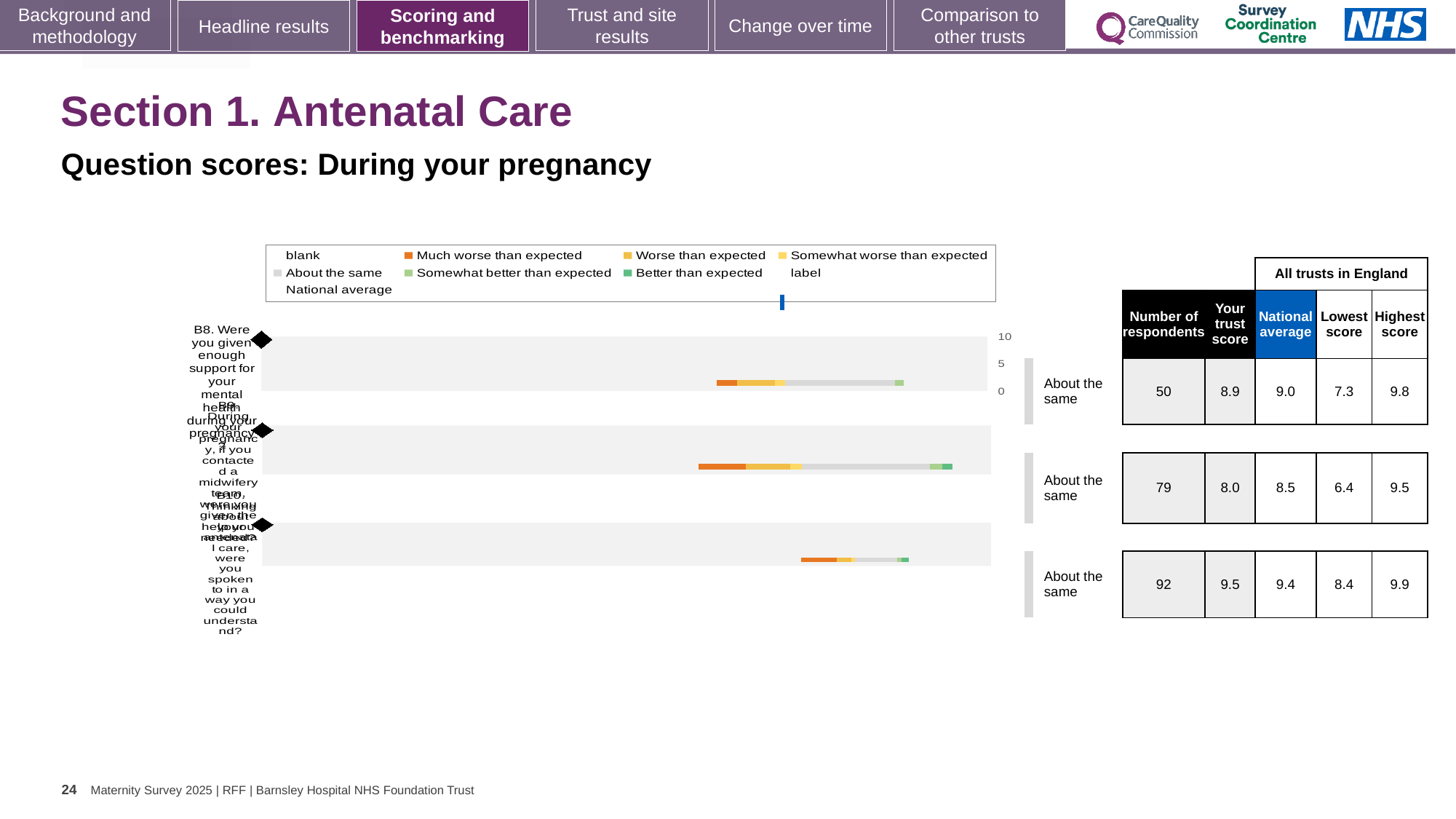
For the second row in the table beside the chart, which is larger: the trust score or the national average? National average In the table beside the chart, what is the lowest score for the third row? 8.4 Which row in the table beside the chart has the highest 'Your trust score'? The third row (9.5) Which legend entry is shown in grey? About the same In the table beside the chart, what is the number of respondents for the third row? 92 What benchmark category is shown next to each of the three bars? About the same Which legend entry is shown in orange? Much worse than expected What kind of chart is shown on the slide? Bar chart In the table beside the chart, what is the national average for the second row? 8.5 In the table beside the chart, what is the difference between the highest score and the lowest score for the first row (B8)? 2.5 How many question bars are plotted in the chart? 3 In the table beside the chart, what is the 'Your trust score' for the first row (B8, support for your mental health during pregnancy)? 8.9